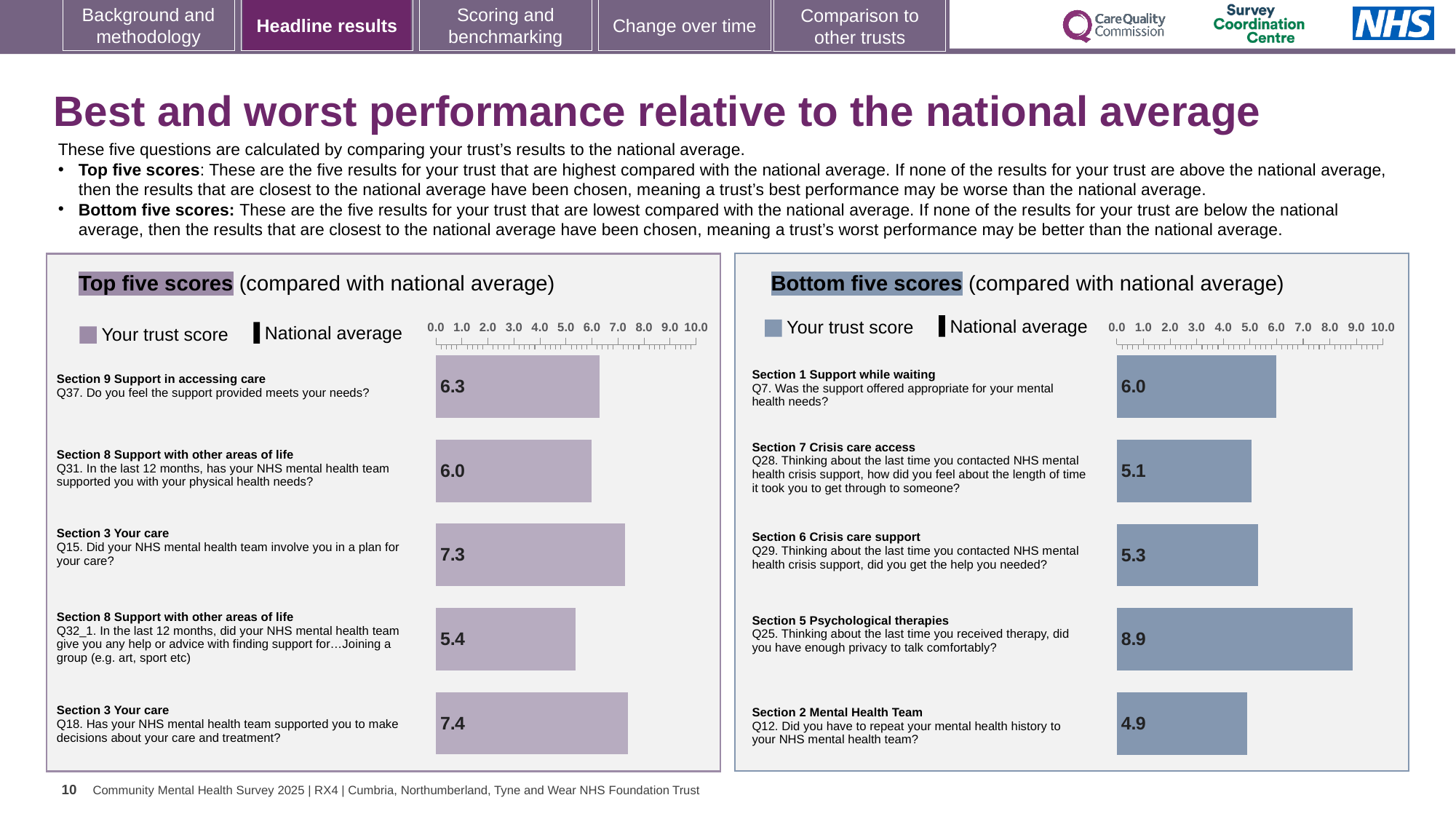
In the 'Bottom five scores' chart, which has the larger trust score: Q28 or Q29? Q29 In the 'Top five scores' chart, what is the difference between the trust scores for Q18 and Q32_1? 2.0 In the 'Top five scores' chart, which question has the lowest trust score? Q32_1 What type of chart is used in the 'Bottom five scores' panel? Bar chart In the 'Bottom five scores' chart, which question has the lowest trust score? Q12 In the 'Top five scores' chart, which question has the highest trust score? Q18 How many questions are shown in the 'Top five scores' chart? 5 In the 'Bottom five scores' chart, what is the trust score for Q25 (Thinking about the last time you received therapy, did you have enough privacy to talk comfortably?)? 8.9 In the 'Bottom five scores' chart, what is the difference between the trust scores for Q7 and Q12? 1.1 In the 'Top five scores' chart, what is the trust score for Q15 (Did your NHS mental health team involve you in a plan for your care?)? 7.3 How many series does the legend of the 'Top five scores' chart list? 2 In the 'Bottom five scores' chart, which question has the highest trust score? Q25